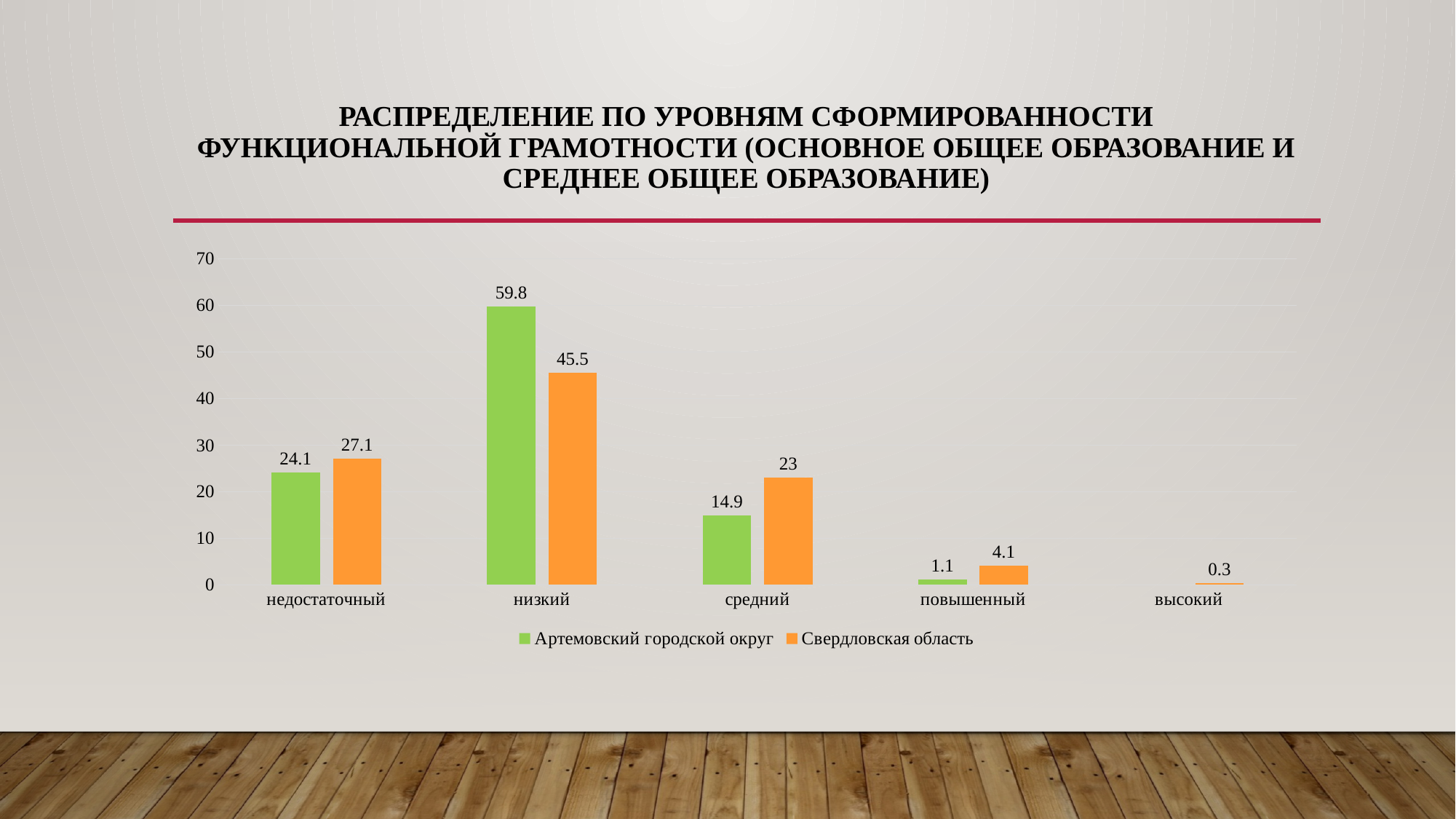
How many series does the legend list? 2 Which colour represents Свердловская область in the chart? orange Is the value for Свердловская область in the низкий category greater or less than 40? greater Which category has the lowest value for Свердловская область? высокий What is the value for Свердловская область in the высокий category? 0.3 Which category has the highest value for Артемовский городской округ? низкий What is the difference between Артемовский городской округ and Свердловская область in the низкий category? 14.3 How many categories are shown on the x axis? 5 What is the value for Свердловская область in the средний category? 23 What is the value for Артемовский городской округ in the низкий category? 59.8 What kind of chart is shown on the slide? bar chart Which is larger in the недостаточный category: Артемовский городской округ or Свердловская область? Свердловская область